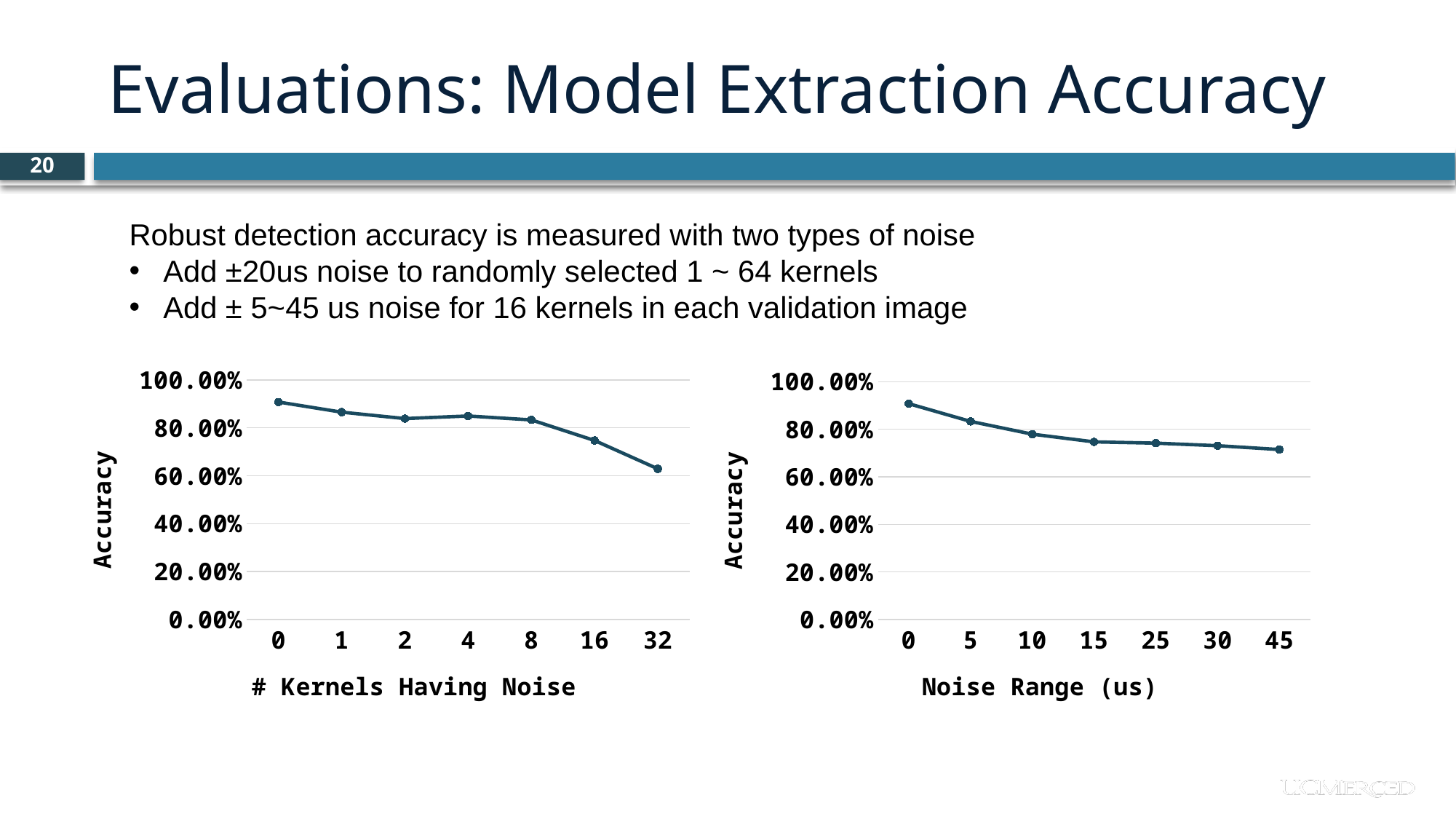
In the right chart (Noise Range (us)), at which noise range is accuracy highest? 0 In the left chart (# Kernels Having Noise), how many data points are plotted? 7 In the left chart (# Kernels Having Noise), is the accuracy at 0 kernels greater or less than 80.00%? greater In the right chart (Noise Range (us)), which has higher accuracy: noise range 0 or noise range 45? 0 In the right chart (Noise Range (us)), is the accuracy at 45 us greater or less than 60.00%? greater In the left chart (# Kernels Having Noise), at which number of kernels is accuracy lowest? 32 In the left chart (# Kernels Having Noise), is the accuracy at 32 kernels greater or less than 80.00%? less In the right chart (Noise Range (us)), how many data points are plotted? 7 In the right chart (Noise Range (us)), does accuracy generally rise or fall as the noise range increases? fall What is the y-axis label of the left chart? Accuracy In the left chart (# Kernels Having Noise), at which number of kernels is accuracy highest? 0 What kind of chart is the left chart, with x axis '# Kernels Having Noise'? line chart